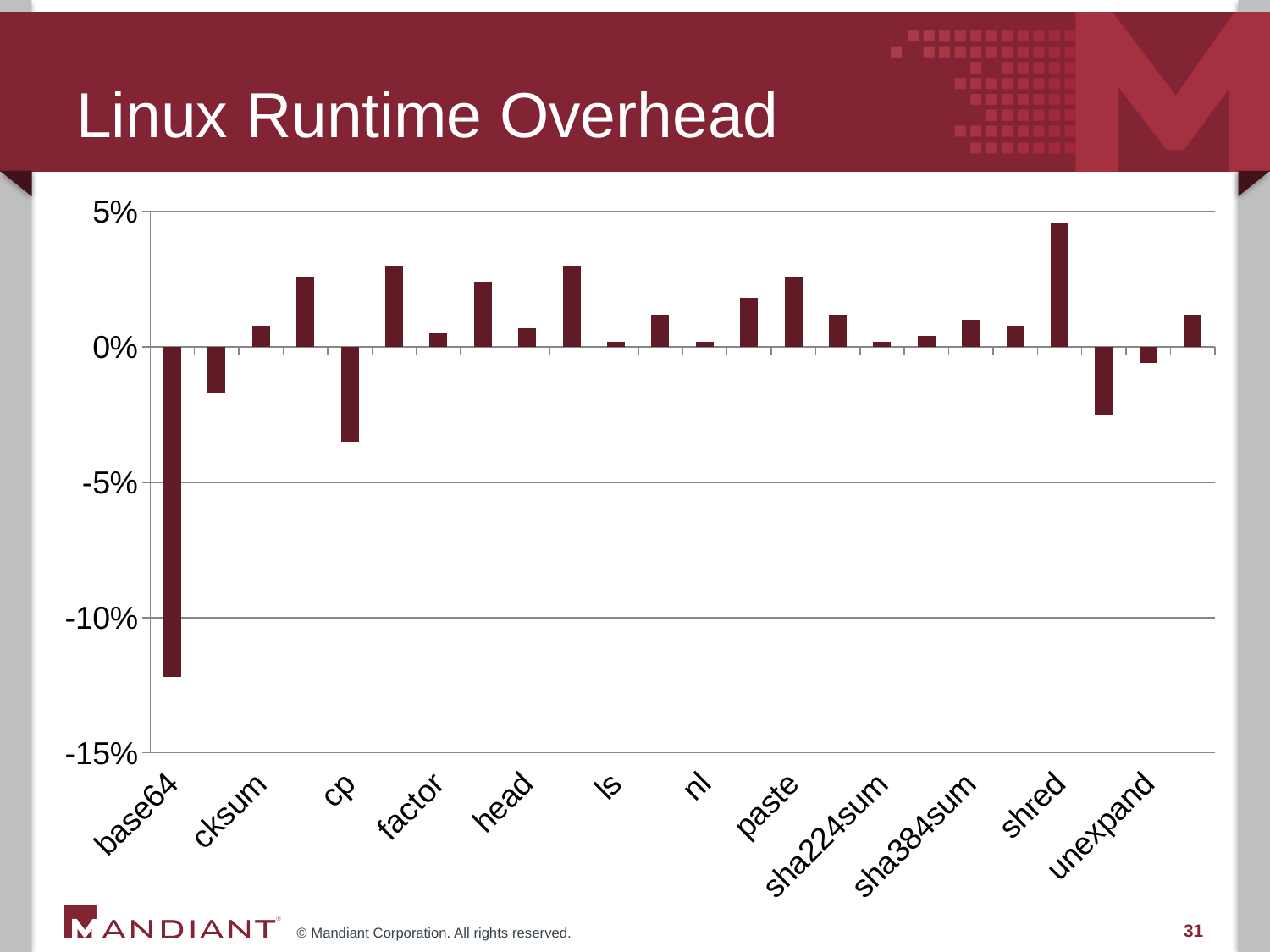
Is the value for cp greater or less than -5%? greater How many category labels are printed along the x axis? 12 Which is larger, the value for base64 or the value for cp? cp What is the lowest value shown on the y axis? -15% Which category has the lowest value in the chart? base64 Is the value for base64 greater or less than -10%? less Is the value for cp greater or less than 0%? less Which is larger, the value for shred or the value for unexpand? shred What is the title of the slide containing the chart? Linux Runtime Overhead What kind of chart is shown on the slide? bar chart